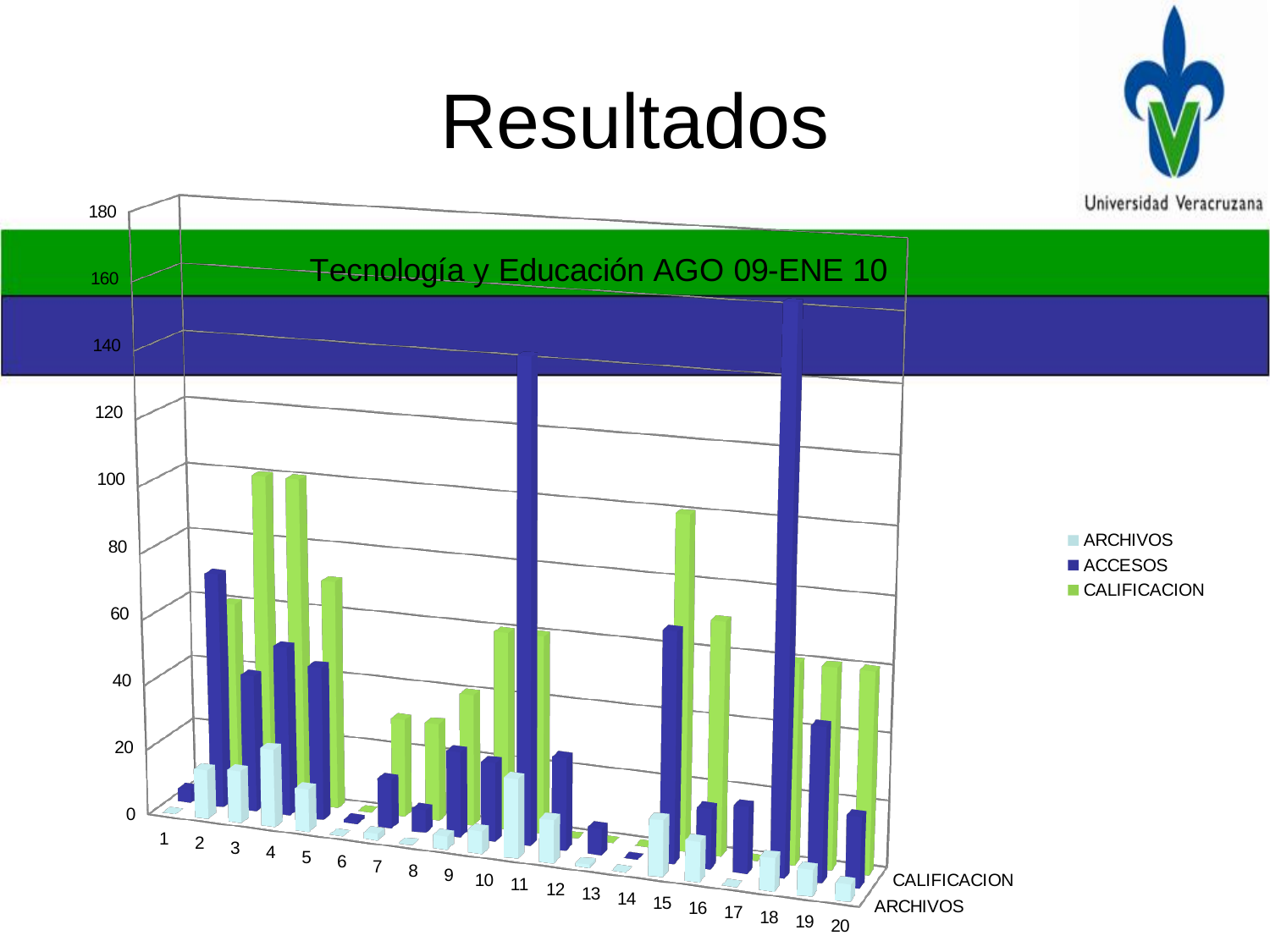
How many categories are shown along the x axis? 20 How many series does the legend list? 3 Which is larger, the CALIFICACION value for category 4 or for category 8? category 4 Is the ACCESOS value for category 11 greater or less than 100? greater Is the CALIFICACION value for category 4 greater or less than 80? greater Which series is shown in green in the legend? CALIFICACION Which is larger, the ACCESOS value for category 18 or for category 11? category 18 Which category has the highest ACCESOS value? 18 What kind of chart is shown on the slide? bar chart Is the CALIFICACION value for category 8 greater or less than 60? less What is the title of the chart? Tecnología y Educación AGO 09-ENE 10